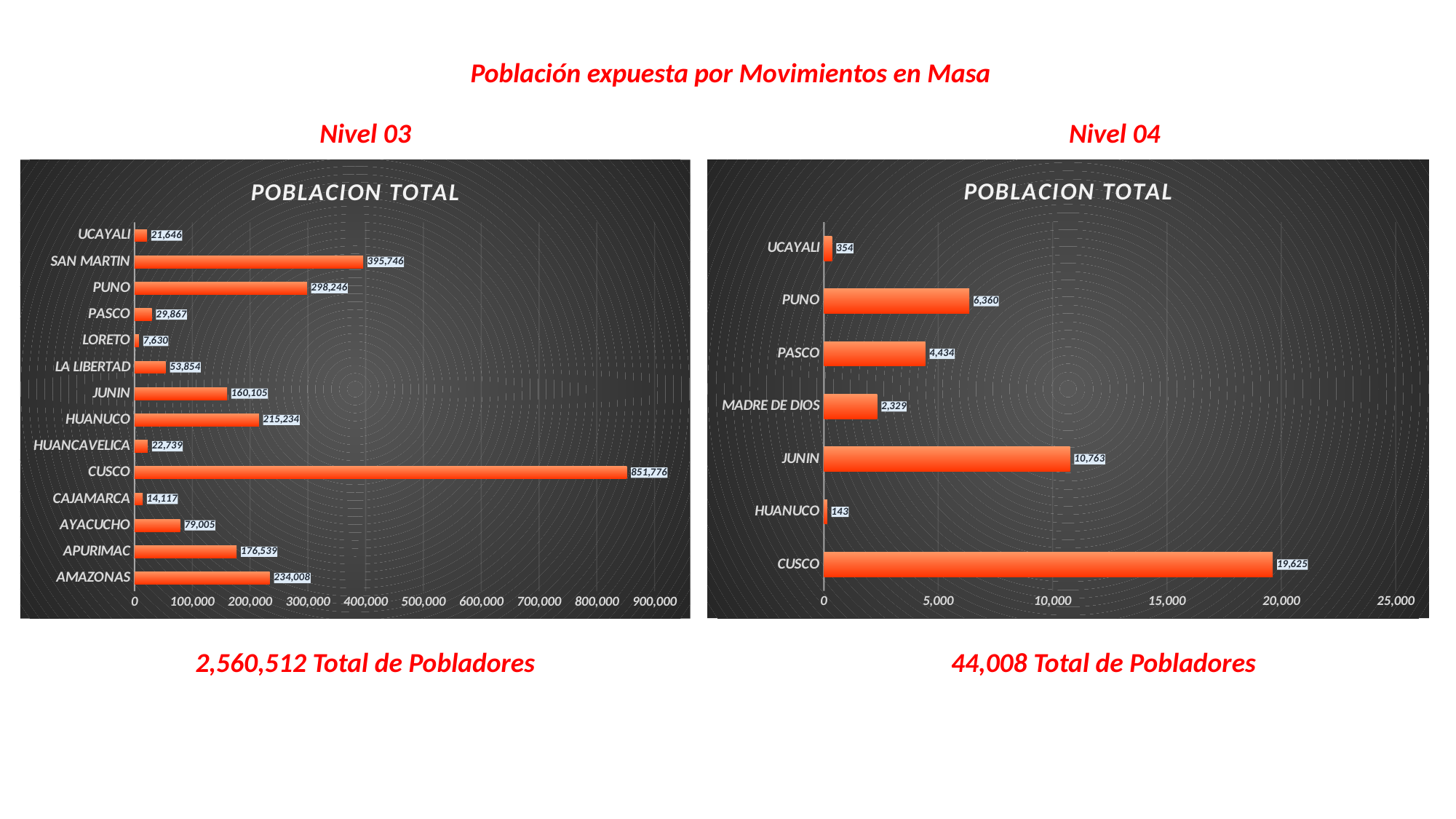
What kind of chart is the Nivel 04 chart on the right? Bar chart In the Nivel 03 chart on the left, which is larger, the value for PUNO or the value for AMAZONAS? PUNO In the Nivel 04 chart on the right, is the value for PUNO greater or less than 5,000? greater How many categories are shown in the Nivel 03 chart on the left? 14 In the Nivel 03 chart on the left, what is the value for CUSCO? 851,776 In the Nivel 04 chart on the right, what is the difference between the values for CUSCO and JUNIN? 8,862 In the Nivel 03 chart on the left, which category has the lowest value? LORETO In the Nivel 04 chart on the right, which category has the lowest value? HUANUCO In the Nivel 04 chart on the right, what is the value for JUNIN? 10,763 In the Nivel 03 chart on the left, what is the difference between the values for CUSCO and SAN MARTIN? 456,030 How many categories are shown in the Nivel 04 chart on the right? 7 In the Nivel 04 chart on the right, which category has the highest value? CUSCO